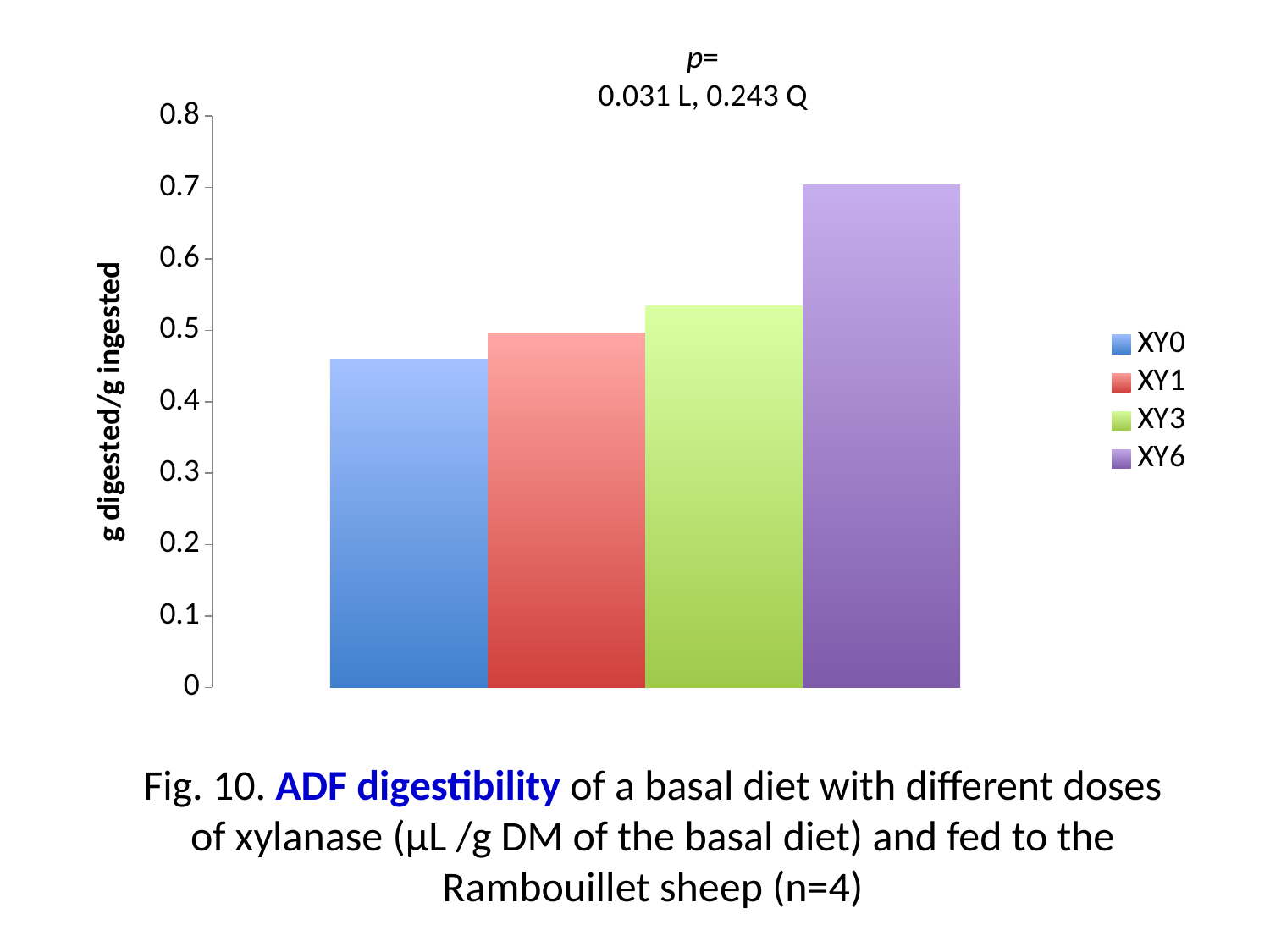
What is the label on the vertical axis of the chart? g digested/g ingested Do the bar values rise or fall from XY0 to XY6 across the chart? rise What kind of chart is shown on the slide? bar chart Is the value for XY3 greater or less than 0.5? greater Is the value for XY6 greater or less than 0.6? greater How many bars are plotted in the chart? 4 Is the value for XY1 greater or less than 0.4? greater Which treatment has the lowest ADF digestibility in the chart? XY0 Which is larger, the value for XY6 or the value for XY0? XY6 Which treatment has the highest ADF digestibility in the chart? XY6 How many entries does the chart legend list? 4